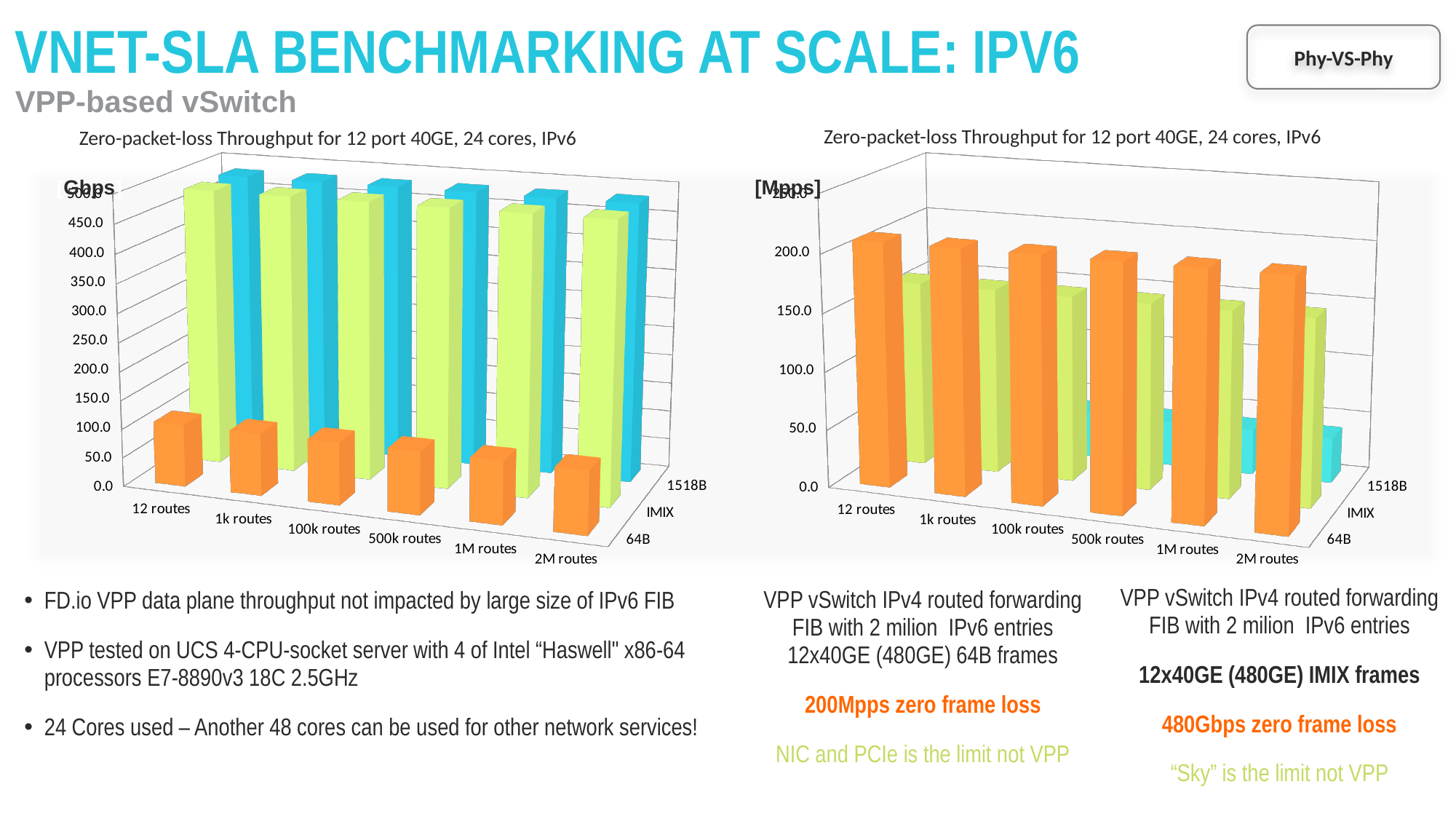
In the left chart (Gbps), is the value for 64B at 12 routes greater or less than 150? less How many frame-size series are plotted in the right chart (Mpps)? 3 What unit is shown on the vertical axis of the right chart? [Mpps] What is the title of the left chart? Zero-packet-loss Throughput for 12 port 40GE, 24 cores, IPv6 In the left chart (Gbps), is the value for 1518B at 2M routes greater or less than 400? greater In the right chart (Mpps), is the value for 64B at 12 routes greater or less than 150? greater In the right chart (Mpps), which frame-size series has the lowest values across all route counts? 1518B In the left chart (Gbps), which is larger at 12 routes, the 1518B value or the 64B value? 1518B In the right chart (Mpps), which is larger at 1k routes, the 64B value or the 1518B value? 64B How many route-count categories are shown along the x axis of the left chart (Gbps)? 6 What kind of chart is the left chart (Gbps)? bar chart